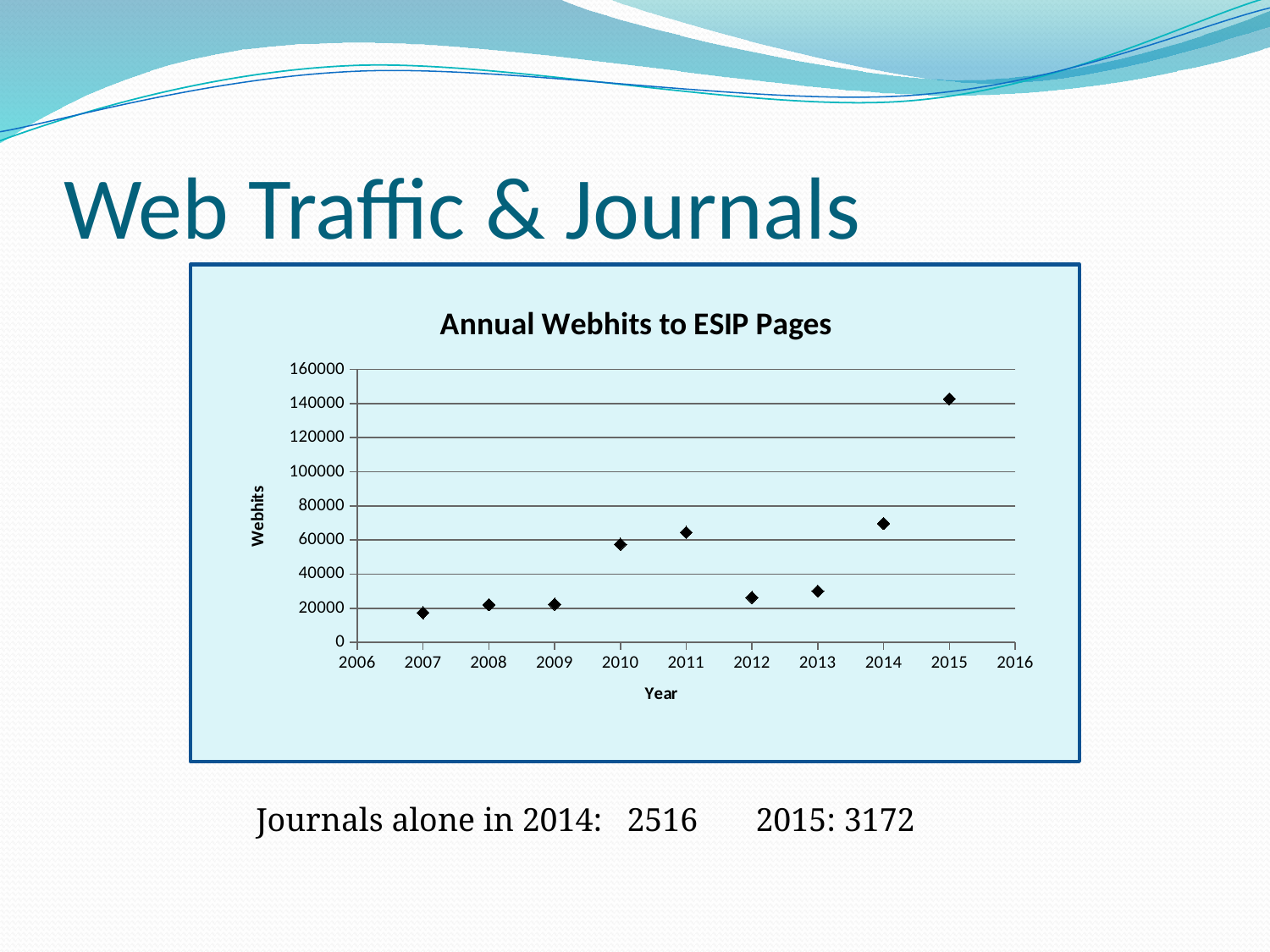
What is the label on the vertical axis of the chart? Webhits Is the value for 2010 greater or less than 40000? greater How many data points are plotted on the chart? 9 What is the title of the chart? Annual Webhits to ESIP Pages Is the value for 2015 greater or less than 120000? greater Is the value for 2012 greater or less than 40000? less Which year has more webhits, 2010 or 2012? 2010 Which year has the lowest number of webhits? 2007 Which year has the highest number of webhits? 2015 Which year has more webhits, 2013 or 2014? 2014 What kind of chart is shown on the slide? scatter chart